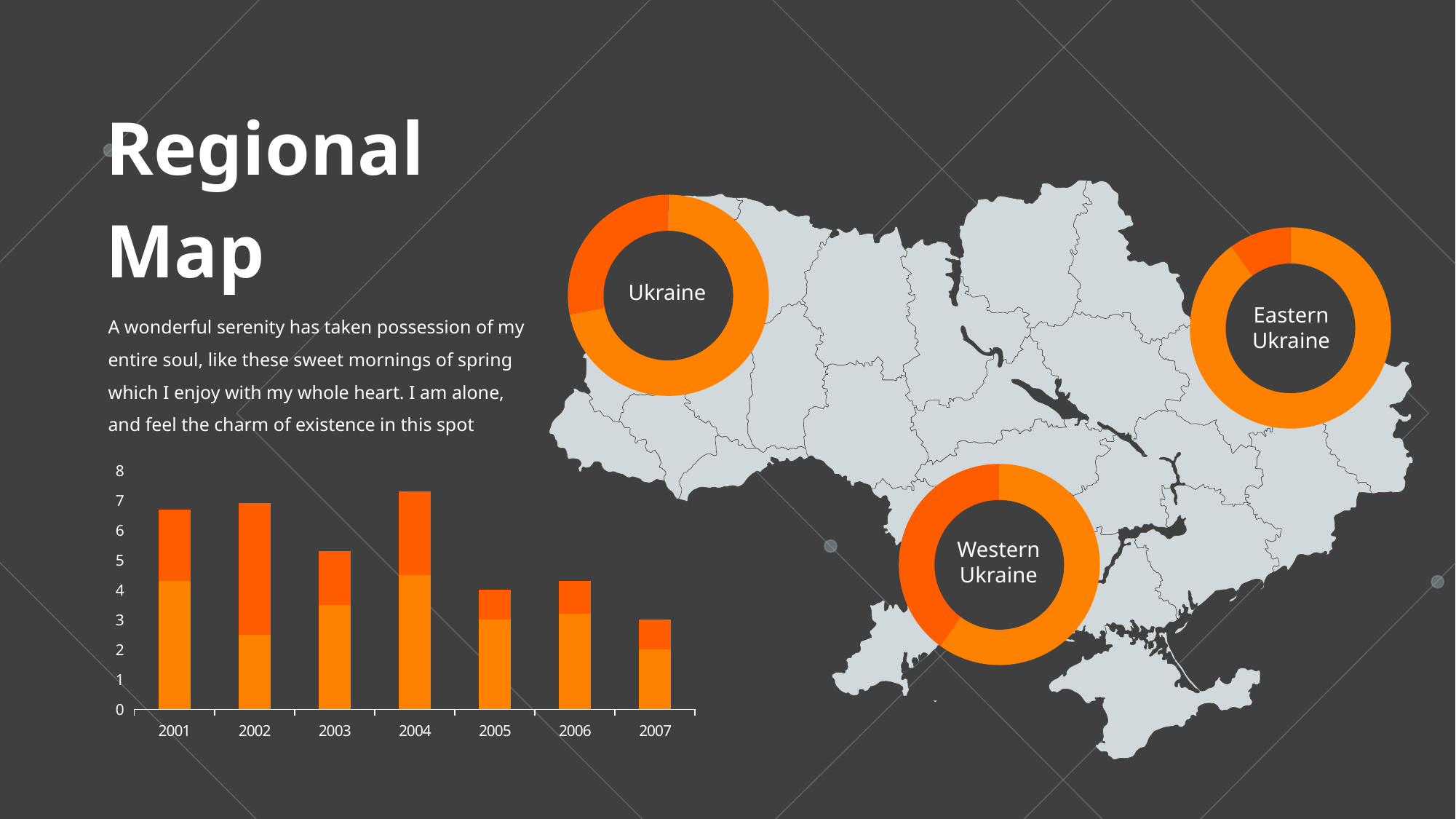
In the bar chart, which year has the shortest bar? 2007 What kind of chart is shown at the bottom left of the slide? bar chart In the bar chart, which year has the tallest bar? 2004 How many donut charts are placed over the map on the slide? 3 How many years are shown on the x axis of the bar chart? 7 In the bar chart, do the bar totals generally rise or fall from 2001 to 2007? fall In the bar chart, which bar is taller, 2001 or 2007? 2001 In the bar chart, is the total value for 2007 greater or less than 4? less In the bar chart, is the total value for 2005 greater or less than 5? less In the bar chart, is the total value for 2003 greater or less than 6? less In the bar chart, which bar is taller, 2003 or 2005? 2003